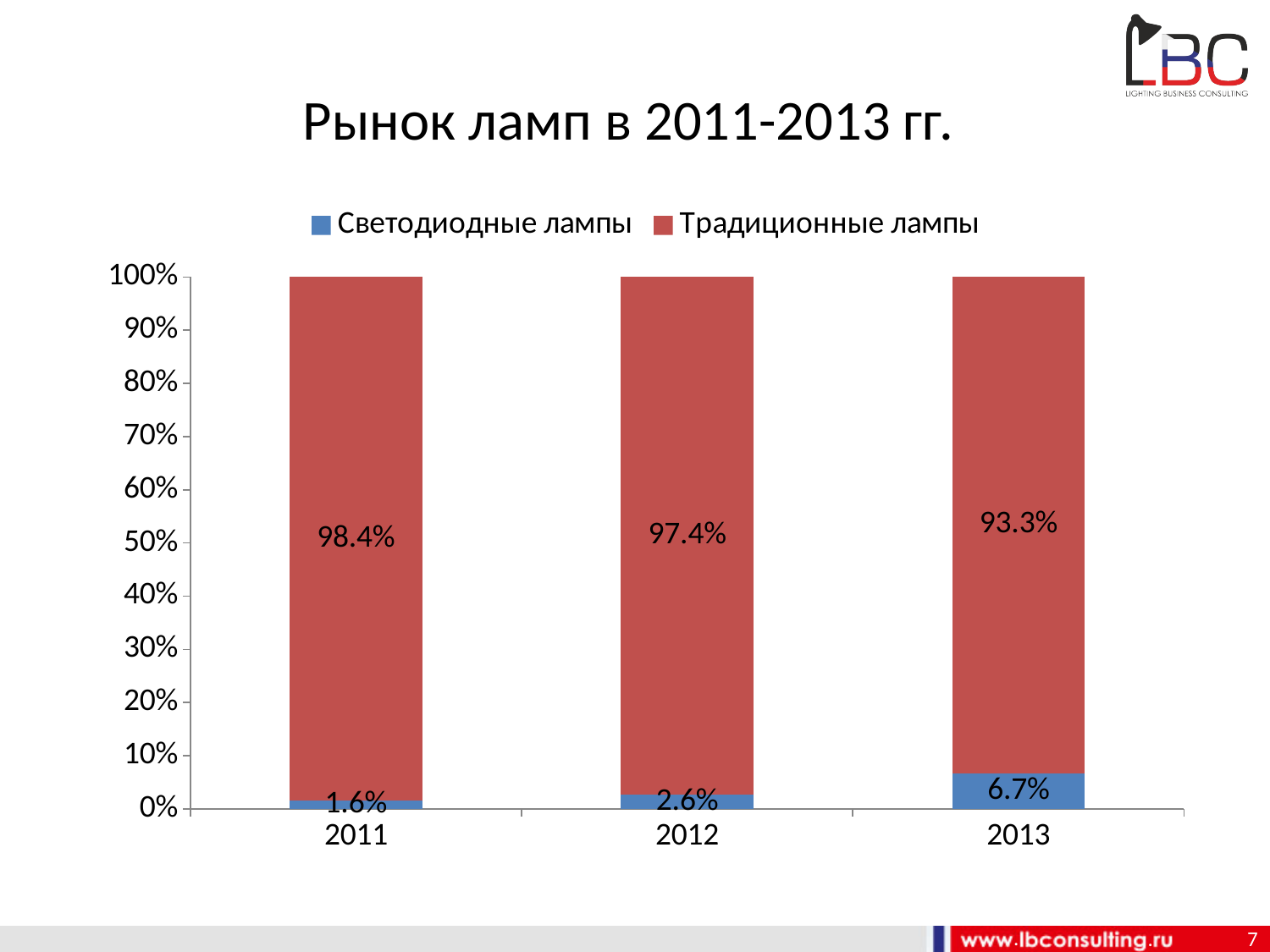
How many years are shown on the x axis? 3 Which is larger: the Традиционные лампы value for 2011 or for 2012? 2011 In which year is the share of Светодиодные лампы highest? 2013 What is the difference between the Светодиодные лампы values for 2013 and 2011? 5.1% How many series does the legend list? 2 What is the value for Светодиодные лампы in 2013? 6.7% What is the value for Традиционные лампы in 2011? 98.4% What kind of chart is shown on the slide? Stacked bar chart Does the share of Светодиодные лампы rise or fall from 2011 to 2013? Rise What is the value for Светодиодные лампы in 2012? 2.6% What is the value for Традиционные лампы in 2013? 93.3% In which year is the share of Традиционные лампы lowest? 2013